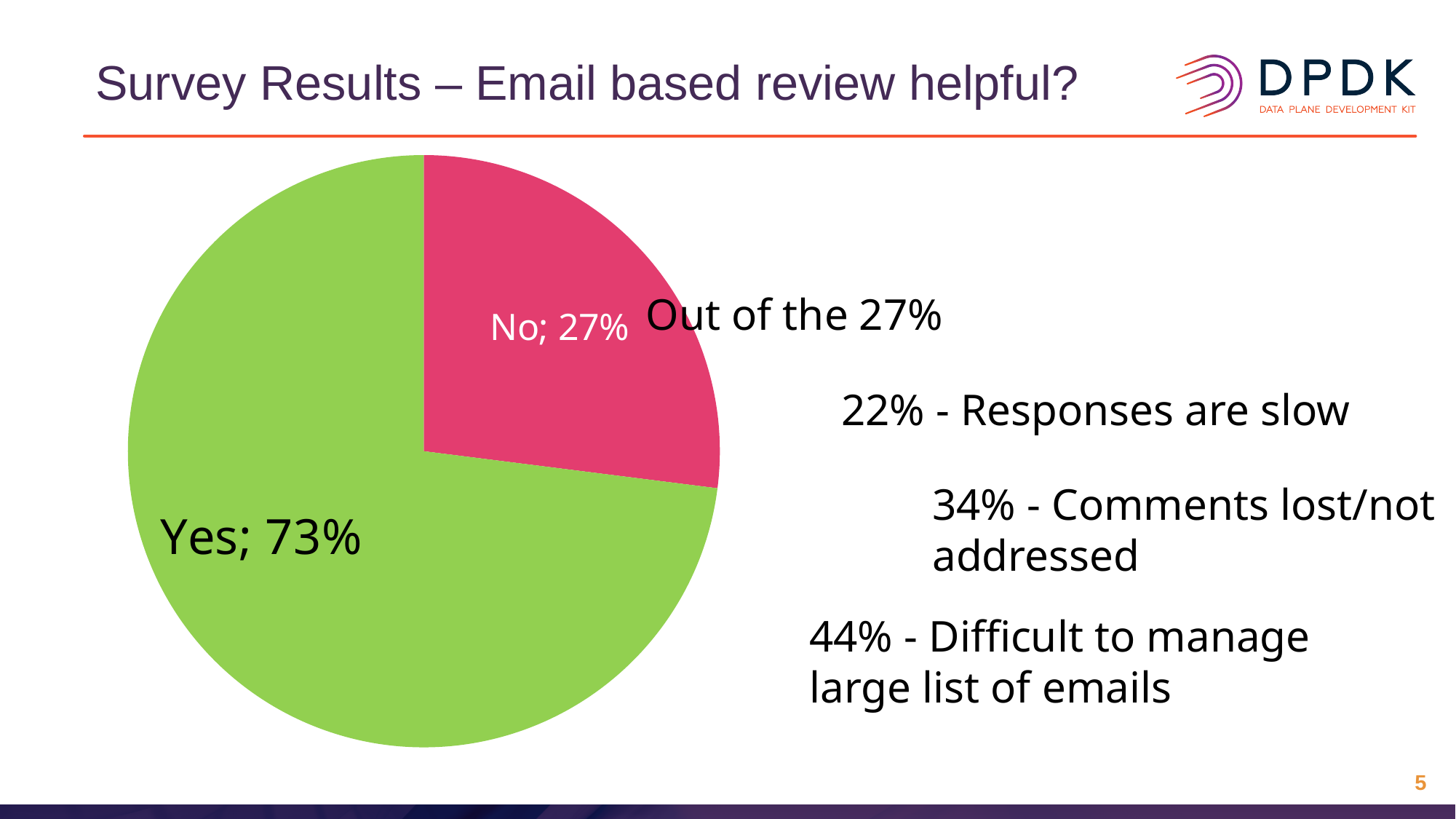
What share of the pie does the No slice represent? 27% Which slice of the pie is the largest? Yes Which slice of the pie is the smallest? No What percentage of respondents answered No? 27% How many slices does the pie chart have? 2 What is the difference in percentage points between the Yes and No slices? 46 Is the value for Yes greater or less than 50%? greater What kind of chart is shown on the slide? pie chart What colour is the No slice of the pie? pink What colour is the Yes slice of the pie? green What percentage of respondents answered Yes? 73% Which is larger, the Yes slice or the No slice? Yes